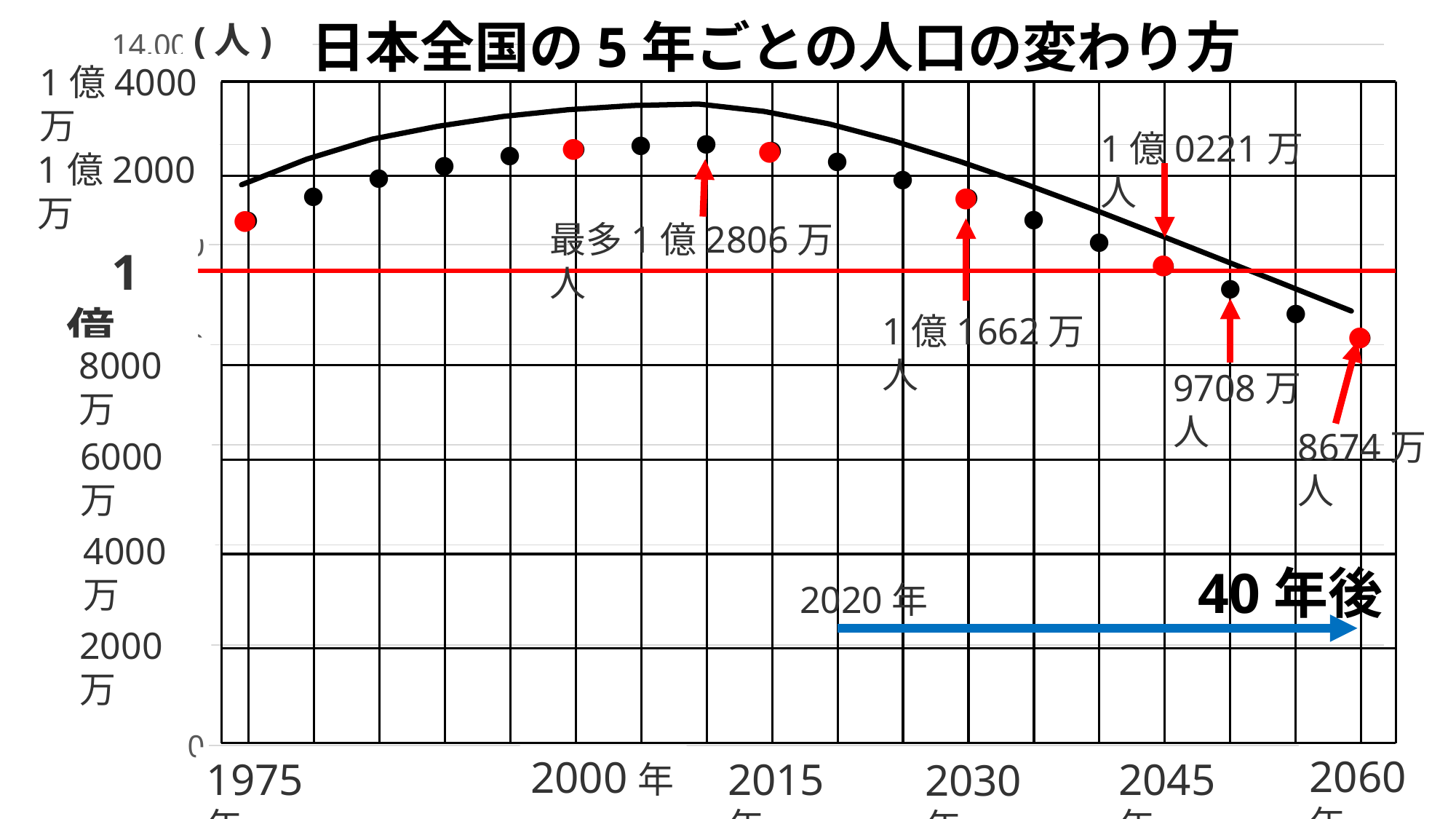
What population value is labeled for 2045年? 1億0221万人 What population value is labeled for 2050年? 9708万人 What is the title of the chart? 日本全国の5年ごとの人口の変わり方 What kind of chart is shown on the slide? line chart Which year has the larger labeled population, 2030年 or 2045年? 2030年 How many data points are plotted on the chart? 18 What population value is labeled for 2030年? 1億1662万人 What is the peak population value labeled on the chart? 1億2806万人 Do the population values rise or fall from 2015年 to 2060年? fall Is the population value for 1975年 greater or less than 1億? greater What population value is labeled for 2060年? 8674万人 What is the difference between the labeled values for 2045年 and 2060年? 1547万人